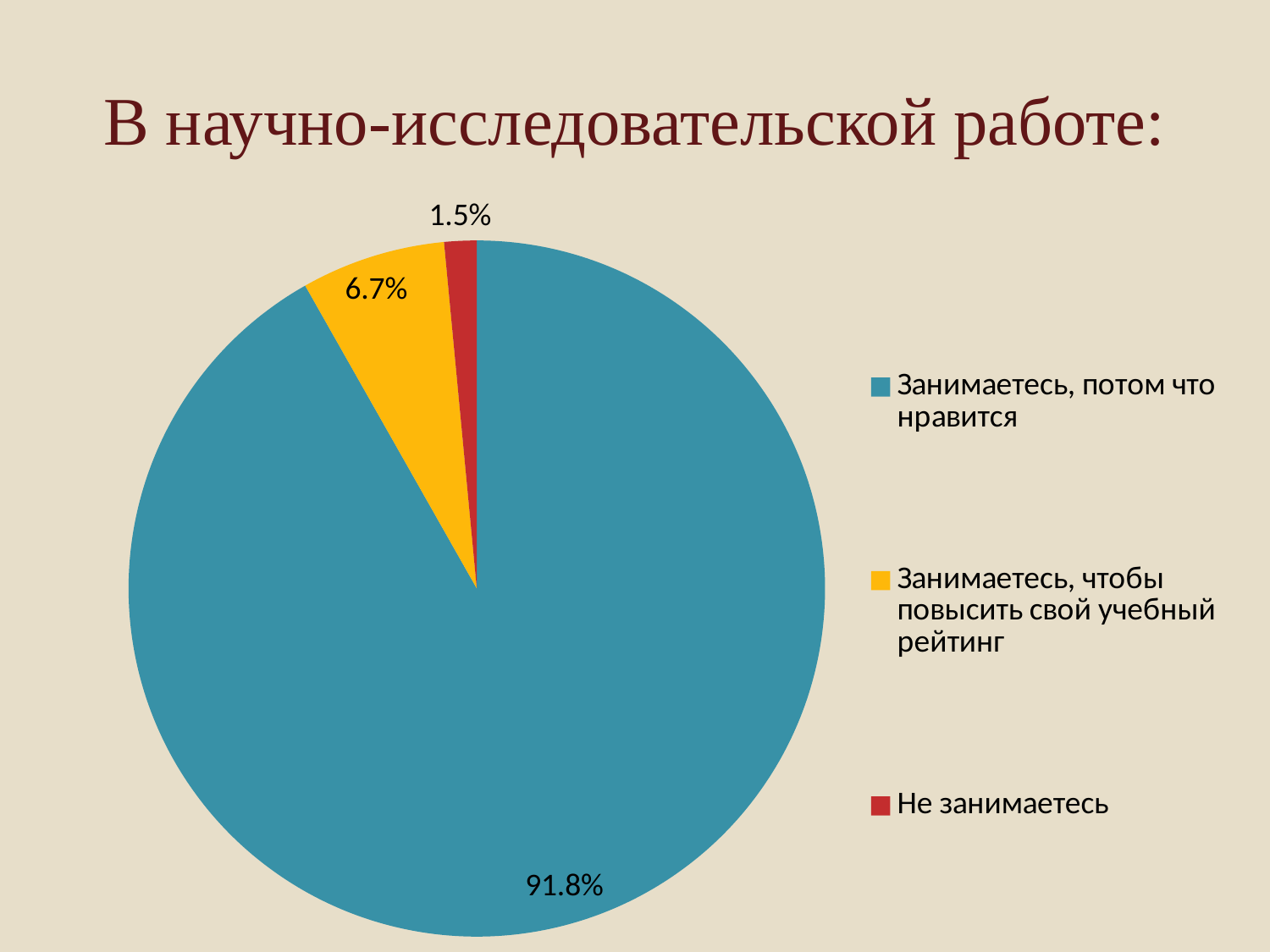
Which is larger: the share for "Занимаетесь, чтобы повысить свой учебный рейтинг" or the share for "Не занимаетесь"? Занимаетесь, чтобы повысить свой учебный рейтинг What kind of chart is shown on the slide? pie chart Which category has the largest slice of the pie? Занимаетесь, потом что нравится Which category has the smallest slice of the pie? Не занимаетесь What is the difference between the shares for "Занимаетесь, потом что нравится" and "Занимаетесь, чтобы повысить свой учебный рейтинг"? 85.1% What is the title of the slide? В научно-исследовательской работе: What is the difference between the shares for "Занимаетесь, чтобы повысить свой учебный рейтинг" and "Не занимаетесь"? 5.2% What share of the pie is labelled "Не занимаетесь"? 1.5% What colour is the slice for "Не занимаетесь"? red What share of the pie is labelled "Занимаетесь, чтобы повысить свой учебный рейтинг"? 6.7% What share of the pie is labelled "Занимаетесь, потом что нравится"? 91.8% How many slices does the pie chart have? 3